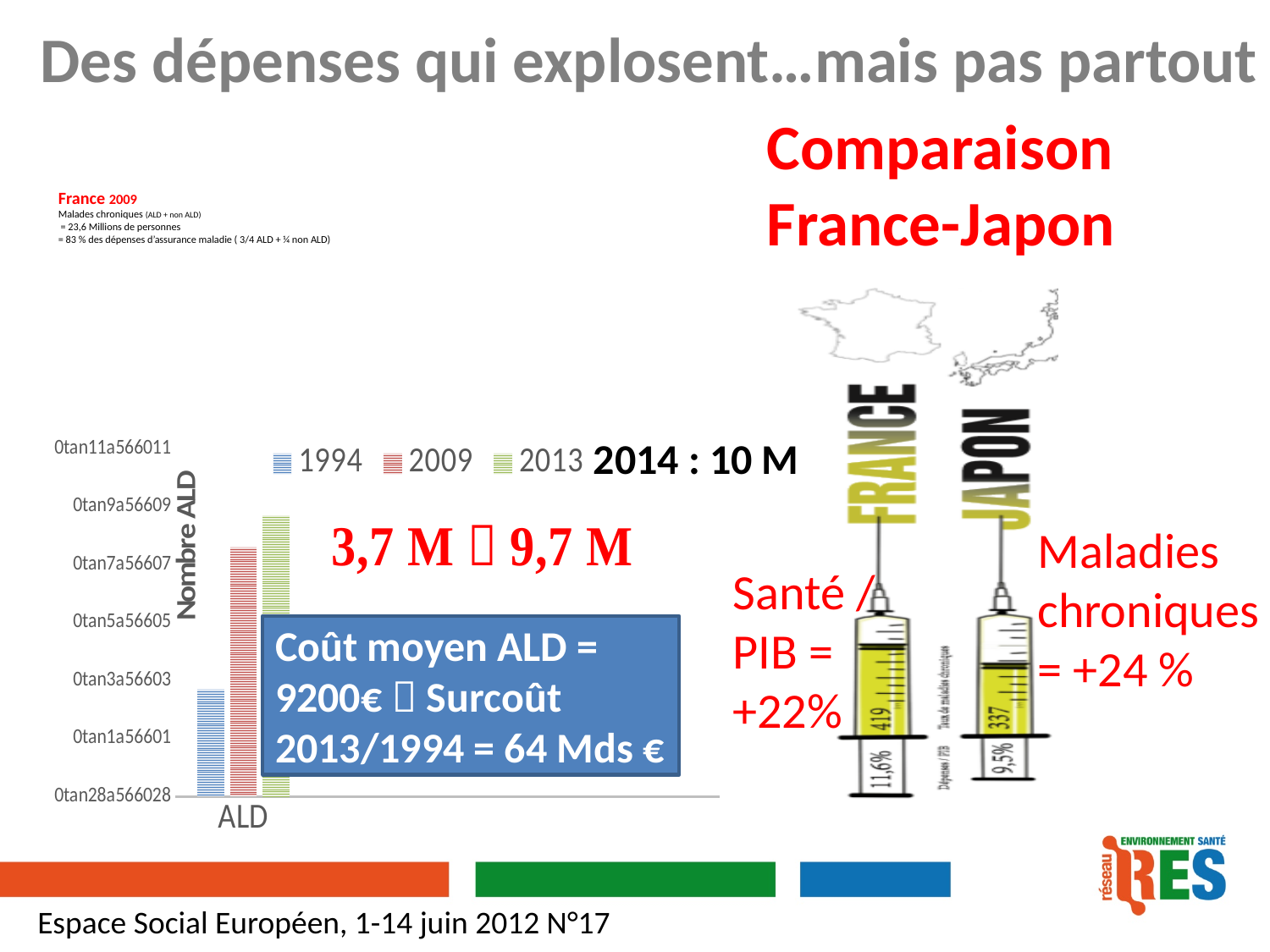
Which series has the tallest bar in the bar chart? 2013 Which series has the shortest bar in the bar chart? 1994 In the bar chart, is the bar for 2009 taller or shorter than the bar for 1994? taller How many series does the legend of the bar chart list? 3 What kind of chart is shown on the left of the slide? bar chart What is the category label on the x axis of the bar chart? ALD In the bar chart, is the bar for 2013 taller or shorter than the bar for 2009? taller Which years are listed in the legend of the bar chart? 1994, 2009, 2013 Do the bar heights rise or fall from 1994 to 2013 in the bar chart? rise How many categories are shown on the x axis of the bar chart? 1